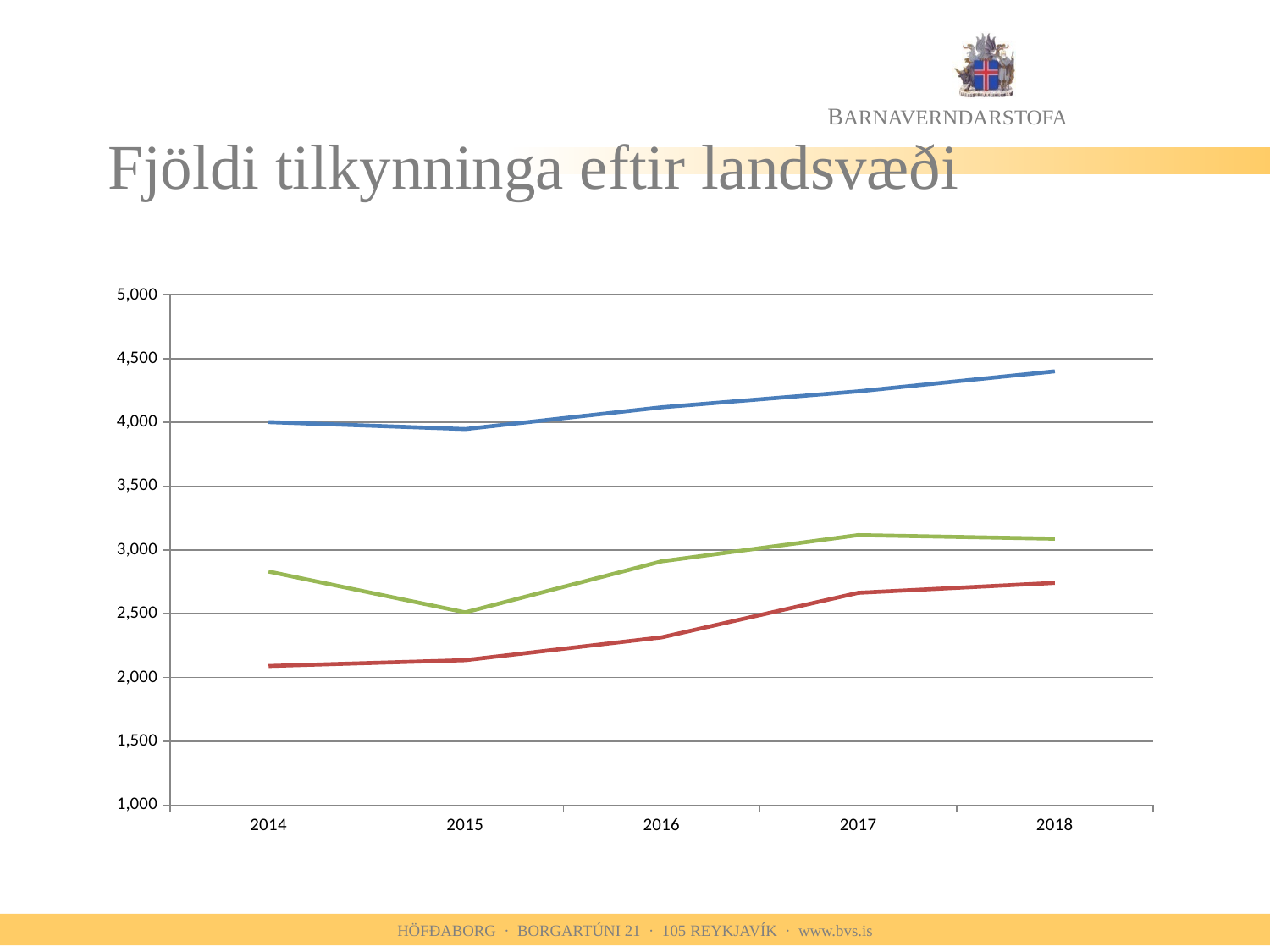
In which year does the green line reach its lowest value? 2015 How many years are shown on the x axis of the chart? 5 Is the value of the red line in 2014 greater or less than 2,500? less Is the value of the blue line in 2018 greater or less than 4,000? greater In 2016, which line has the larger value, the green line or the red line? green line Does the red line rise or fall from 2014 to 2018? rise In which year does the blue line reach its highest value? 2018 Is the value of the red line in 2018 greater or less than 2,500? greater How many lines are plotted on the chart? 3 What is the title of the slide containing the chart? Fjöldi tilkynninga eftir landsvæði What kind of chart is shown on the slide? line chart